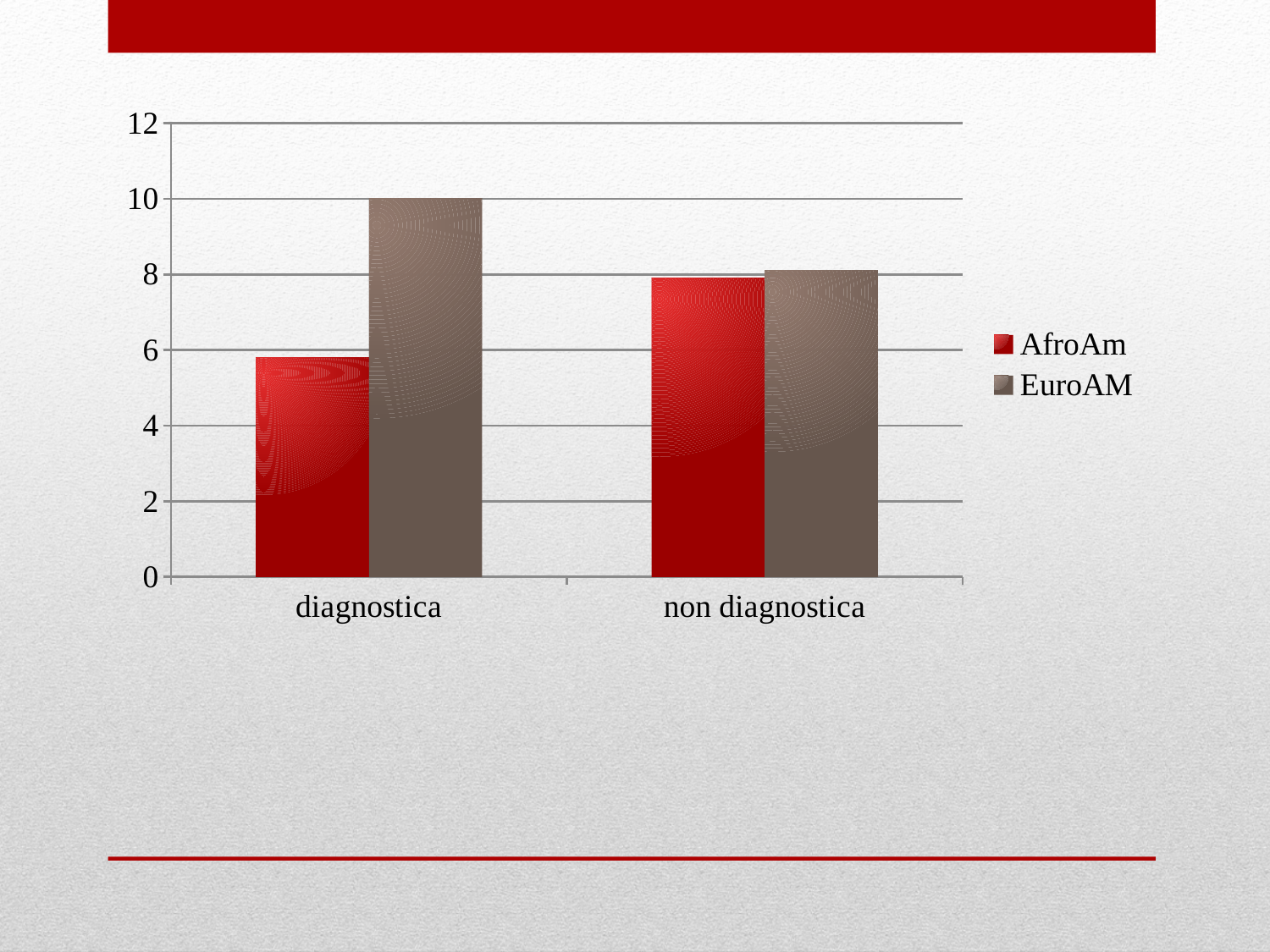
In which category is the EuroAM value highest? diagnostica In the diagnostica category, which series has the larger value, AfroAm or EuroAM? EuroAM Is the value for AfroAm in the diagnostica category greater or less than 6? less Does the AfroAm value rise or fall from diagnostica to non diagnostica? rise Is the value for EuroAM in the non diagnostica category greater or less than 10? less How many series does the legend list? 2 What kind of chart is shown on the slide? bar chart What are the two entries listed in the legend? AfroAm and EuroAM In which category is the AfroAm value lowest? diagnostica How many categories are shown on the x axis? 2 What is the value for EuroAM in the diagnostica category? 10 Is the value for AfroAm in the non diagnostica category greater or less than 6? greater